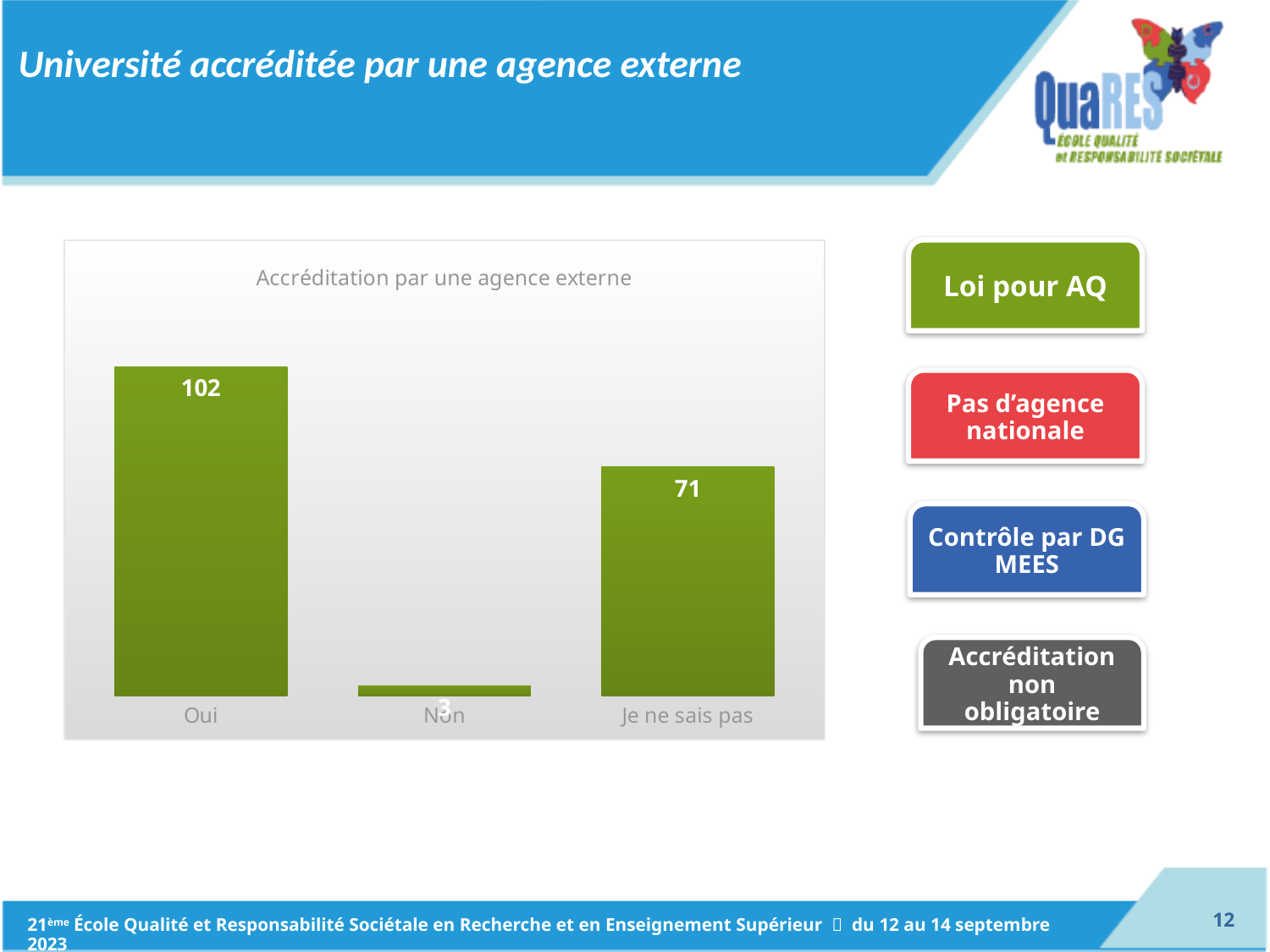
What is the difference between the values for "Oui" and "Je ne sais pas"? 31 What kind of chart is shown on the slide? Bar chart Which category has the highest value? Oui What is the value for "Oui"? 102 What is the difference between the values for "Je ne sais pas" and "Non"? 68 Which category has the lowest value? Non What is the value for "Non"? 3 What is the value for "Je ne sais pas"? 71 What is the title of the chart? Accréditation par une agence externe Which is larger, the value for "Oui" or the value for "Je ne sais pas"? Oui What is the total of the three values shown in the chart? 176 How many categories are shown on the x axis? 3